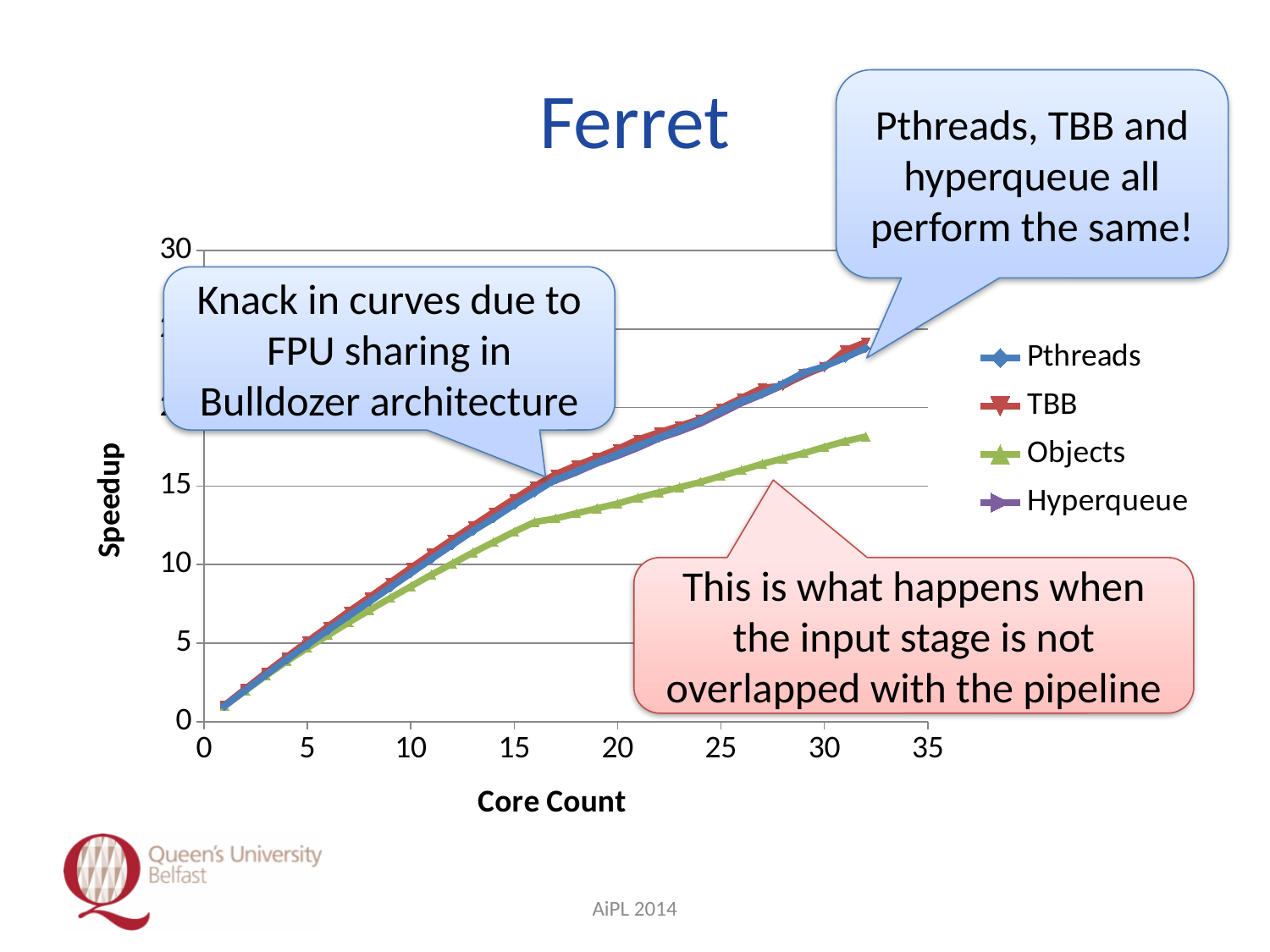
Which series has the lowest speedup at 32 cores? Objects At 30 cores, which series has the larger speedup, TBB or Objects? TBB What kind of chart is shown on the slide? line chart Is the speedup for Objects at 32 cores greater or less than 20? less Does the speedup for the Objects series rise or fall as core count increases? rise Is the speedup for Objects at 32 cores greater or less than 15? greater Does the speedup for the TBB series rise or fall as core count increases? rise What is the title of the chart? Ferret What is the label of the x axis? Core Count Is the speedup for TBB at 32 cores greater or less than 20? greater How many series does the legend list? 4